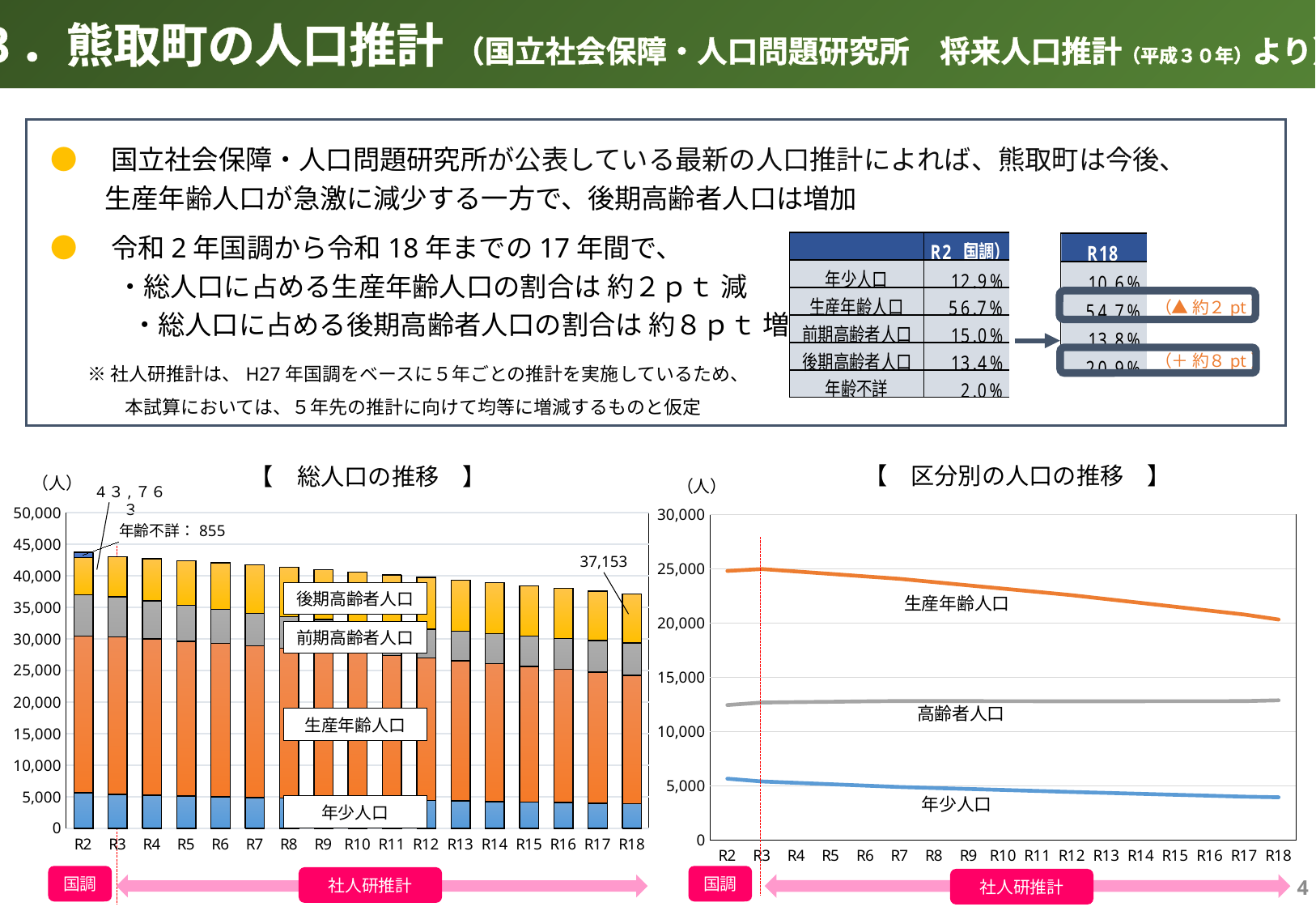
In the left chart 総人口の推移, what is the total population labelled for R2? 43,763 In the left chart 総人口の推移, what value is labelled for 年齢不詳? 855 What kind of chart is the right chart titled 区分別の人口の推移? line chart In the right chart 区分別の人口の推移, does 生産年齢人口 rise or fall from R2 to R18? fall In the left chart 総人口の推移, what is the total population labelled for R18? 37,153 In the left chart 総人口の推移, what is the difference between the labelled totals for R2 and R18? 6,610 In the left chart 総人口の推移, how many years are shown on the x axis? 17 In the right chart 区分別の人口の推移, which line is the lowest? 年少人口 What kind of chart is the left chart titled 総人口の推移? bar chart In the left chart 総人口の推移, does the total population rise or fall from R2 to R18? fall In the right chart 区分別の人口の推移, is the value for 年少人口 at R2 greater or less than 10,000? less In the right chart 区分別の人口の推移, which line is the highest? 生産年齢人口